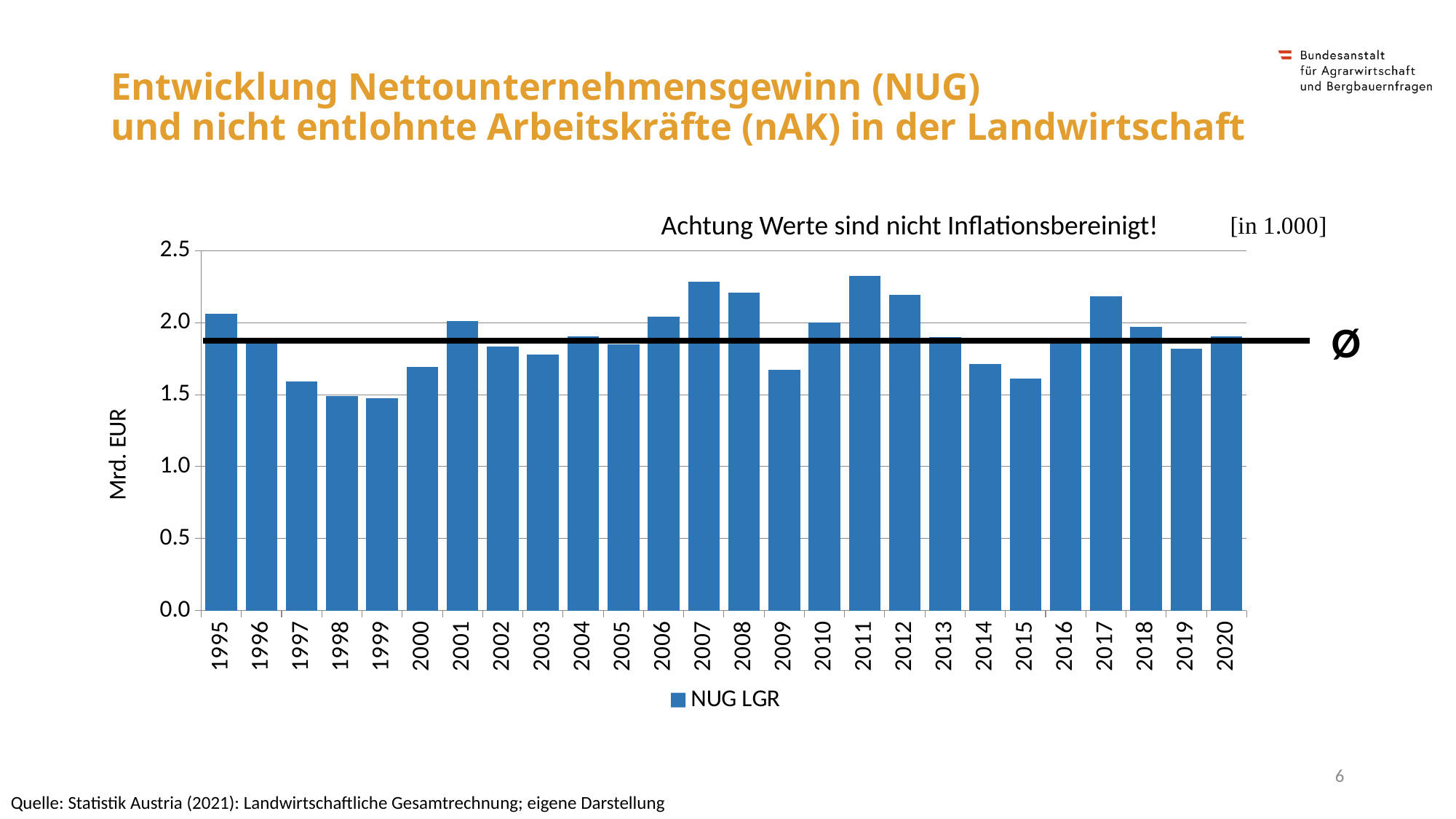
What is the name of the series shown in the legend? NUG LGR Which year has the larger value, 1997 or 2001? 2001 What kind of chart is shown on the slide? bar chart How many series does the legend list? 1 Do the values rise or fall from 1995 to 1999? fall What is the label of the y axis? Mrd. EUR Which year has the larger value, 2007 or 2009? 2007 Is the value for 2009 greater or less than 2.0? less How many years are shown on the x axis of the chart? 26 Is the value for 2017 greater or less than 2.0? greater Is the value for 1995 greater or less than 2.0? greater